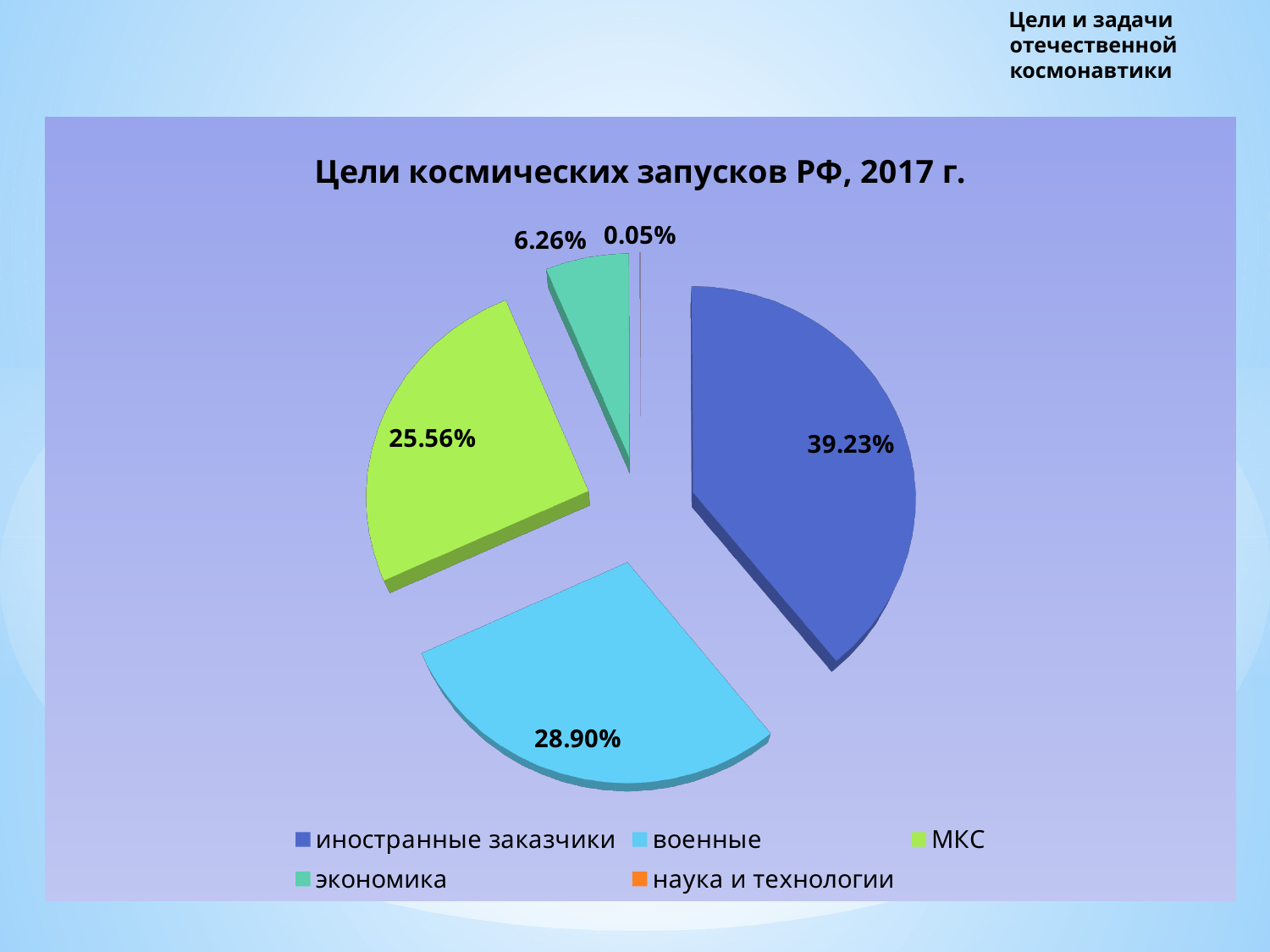
Which category has the smallest share of the pie? наука и технологии What share of the pie does "иностранные заказчики" have? 39.23% How many categories does the legend list? 5 What share of the pie does "военные" have? 28.90% Which category has the largest share of the pie? иностранные заказчики What share of the pie does "экономика" have? 6.26% What type of chart is shown on the slide? pie chart What is the title of the chart? Цели космических запусков РФ, 2017 г. Which is larger, the share of "военные" or the share of "МКС"? военные What share of the pie does "наука и технологии" have? 0.05% What is the difference between the shares of "иностранные заказчики" and "военные"? 10.33% What share of the pie does "МКС" have? 25.56%